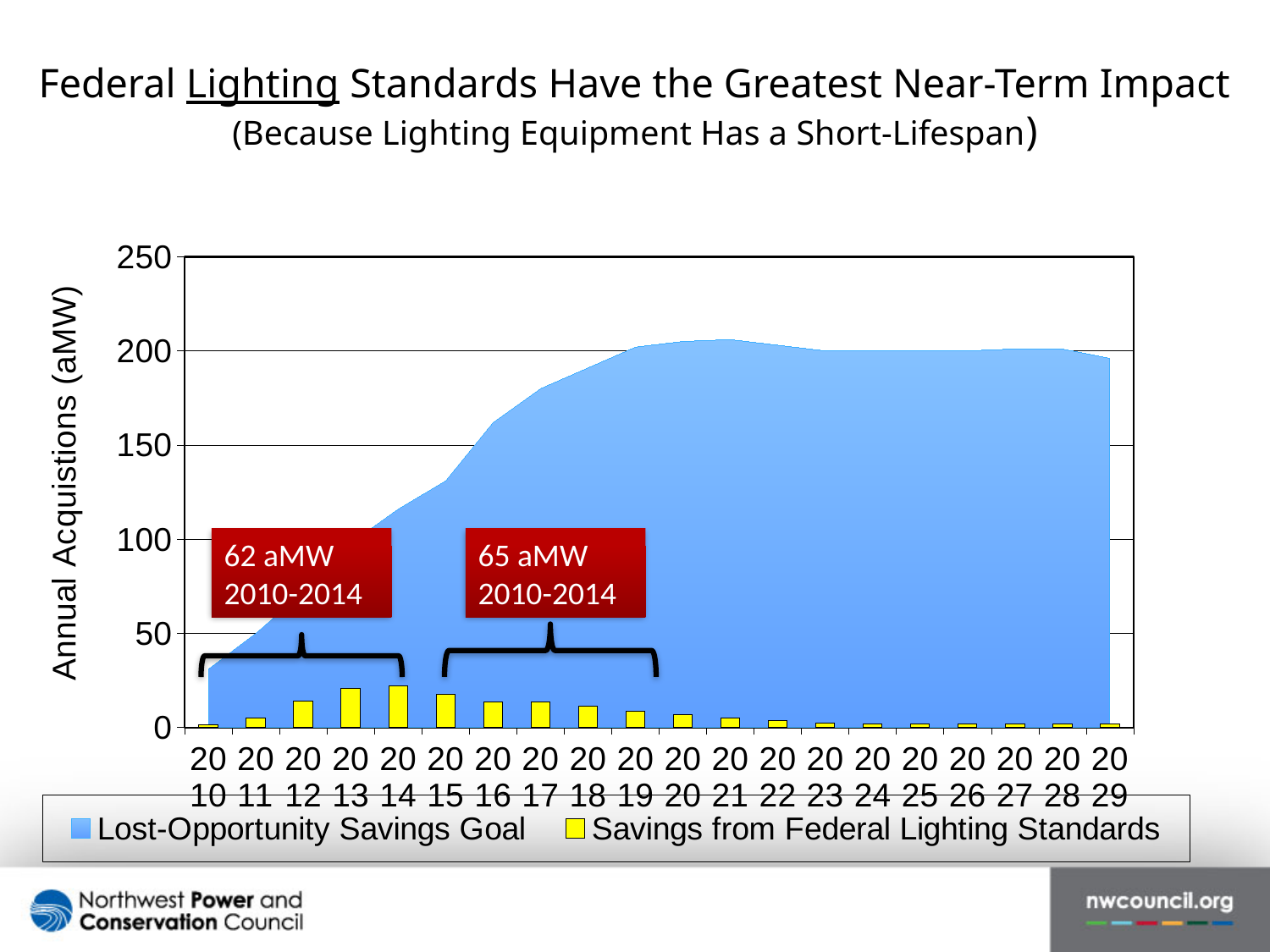
Is the Lost-Opportunity Savings Goal for 2010 greater or less than 50? less Do the Savings from Federal Lighting Standards rise or fall from 2014 to 2029? fall How many years are shown along the x axis of the chart? 20 How many series does the chart legend list? 2 Which is larger, the Savings from Federal Lighting Standards in 2014 or in 2022? 2014 Is the Savings from Federal Lighting Standards value for 2014 greater or less than 50? less Does the Lost-Opportunity Savings Goal rise or fall from 2010 to 2020? rise Is the Lost-Opportunity Savings Goal for 2015 greater or less than 100? greater Which is larger, the Lost-Opportunity Savings Goal in 2010 or in 2018? 2018 What are the two series named in the chart legend? Lost-Opportunity Savings Goal; Savings from Federal Lighting Standards What is the title of the chart's y axis? Annual Acquistions (aMW)